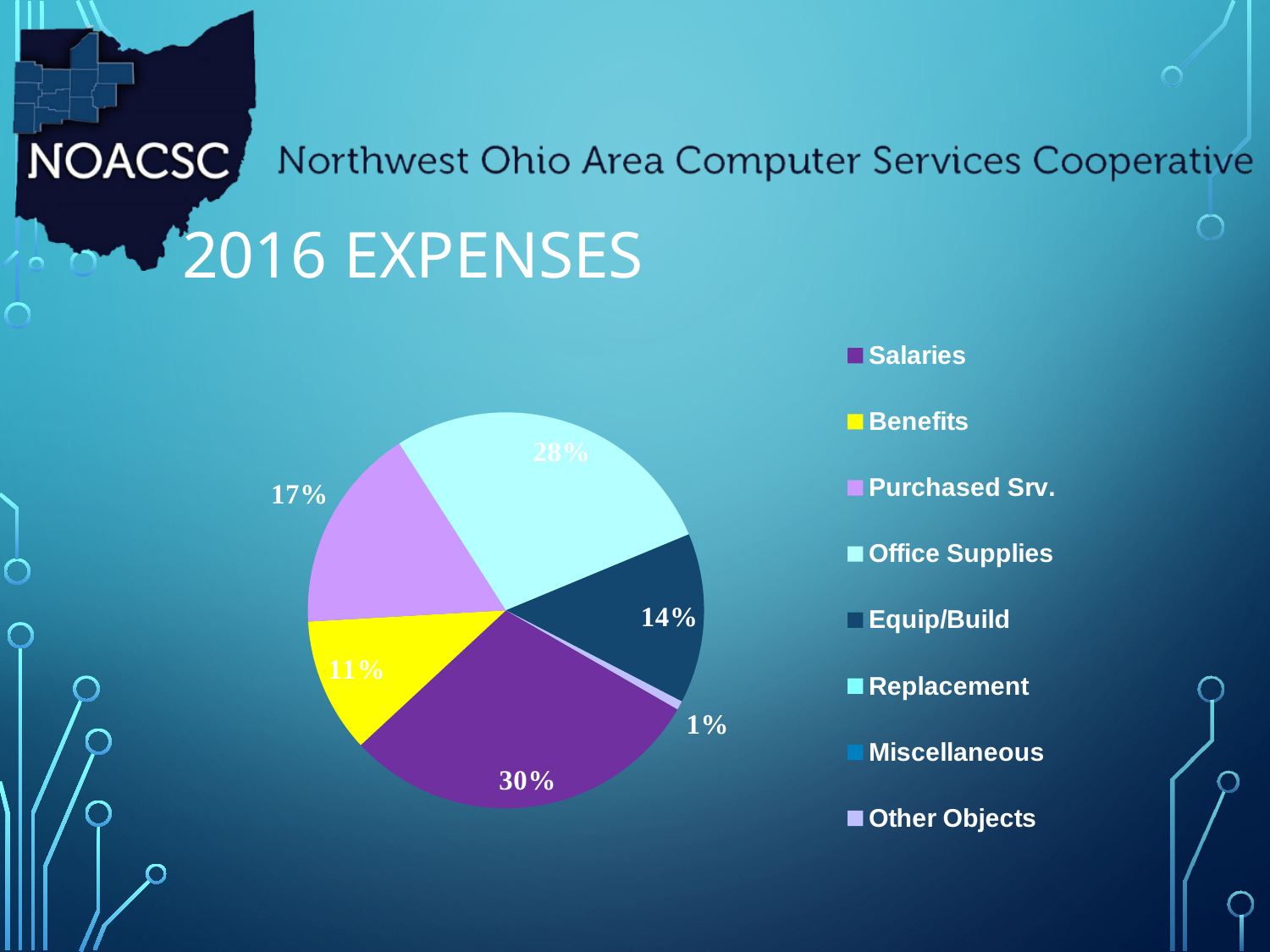
Which is larger, the share for Purchased Srv. or the share for Equip/Build? Purchased Srv. What is the smallest percentage labelled on the pie chart? 1% What is the title of the slide's chart? 2016 EXPENSES Which category has the largest share of 2016 expenses? Salaries What colour is the Benefits slice in the pie chart? yellow What percentage of 2016 expenses is Benefits? 11% What type of chart is shown on the slide? pie chart What percentage of 2016 expenses is Equip/Build? 14% How many entries does the legend list? 8 What is the difference in percentage points between Salaries and Benefits? 19 What percentage of 2016 expenses is Purchased Srv.? 17% What percentage of 2016 expenses is Salaries? 30%